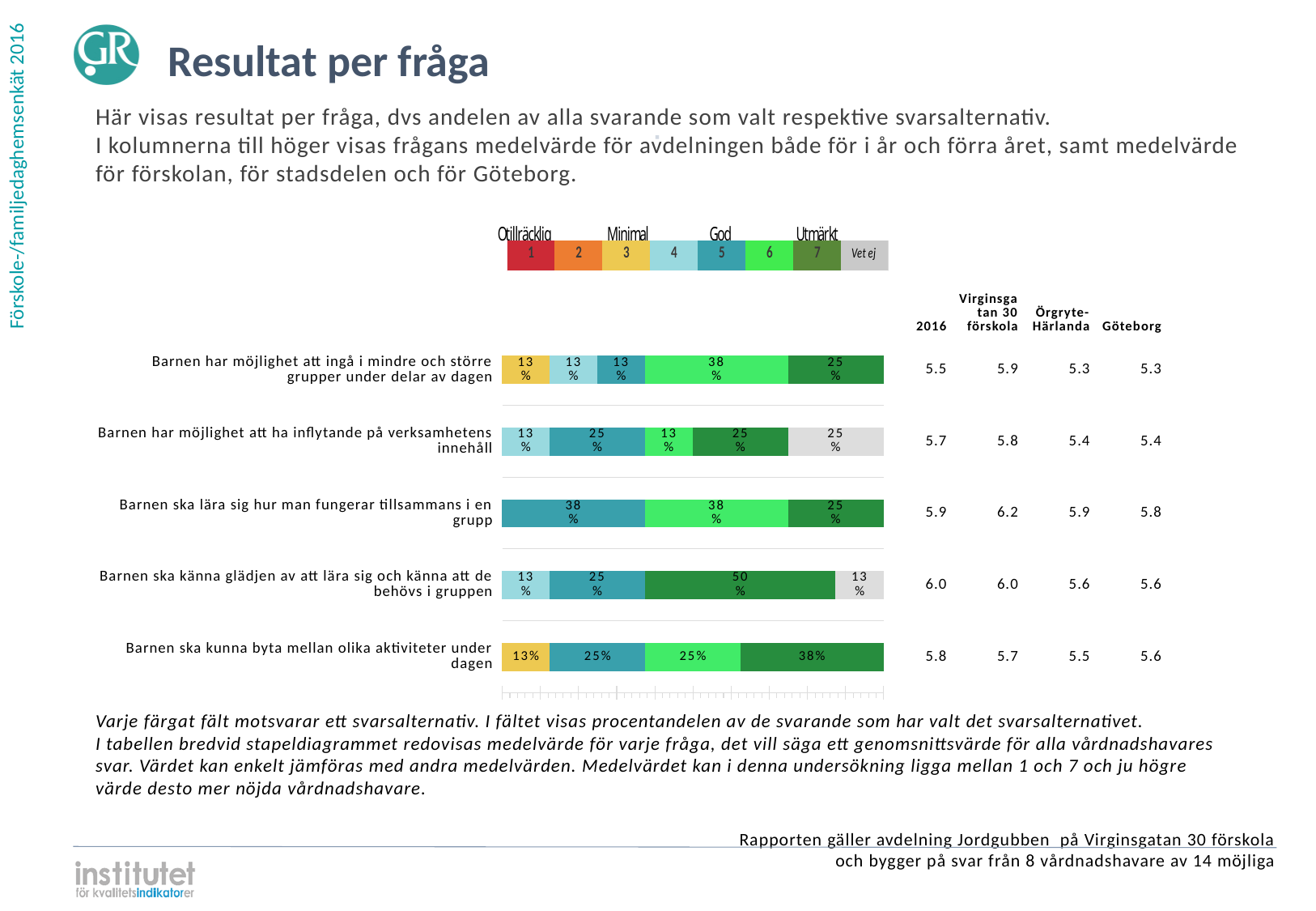
What is the 2016 mean value shown for 'Barnen ska känna glädjen av att lära sig och känna att de behövs i gruppen'? 6.0 How many questions (categories) are plotted in the bar chart? 5 What kind of chart is shown on the slide? Stacked bar chart What share of respondents chose option 6 (bright green) for 'Barnen har möjlighet att ingå i mindre och större grupper under delar av dagen'? 38% For 'Barnen ska kunna byta mellan olika aktiviteter under dagen', which is larger: the option 3 (yellow) share or the option 5 (teal) share? Option 5 (25%) What share of respondents chose option 7 (dark green) for 'Barnen ska känna glädjen av att lära sig och känna att de behövs i gruppen'? 50% What is the title of the slide? Resultat per fråga For 'Barnen ska lära sig hur man fungerar tillsammans i en grupp', what is the difference between the option 5 share and the option 7 share? 13 percentage points Which question has the largest single segment in its bar? Barnen ska känna glädjen av att lära sig och känna att de behövs i gruppen What share of respondents answered 'Vet ej' for 'Barnen har möjlighet att ha inflytande på verksamhetens innehåll'? 25% How many answer options does the legend above the chart list, including 'Vet ej'? 8 What share of respondents chose option 7 (dark green) for 'Barnen ska kunna byta mellan olika aktiviteter under dagen'? 38%